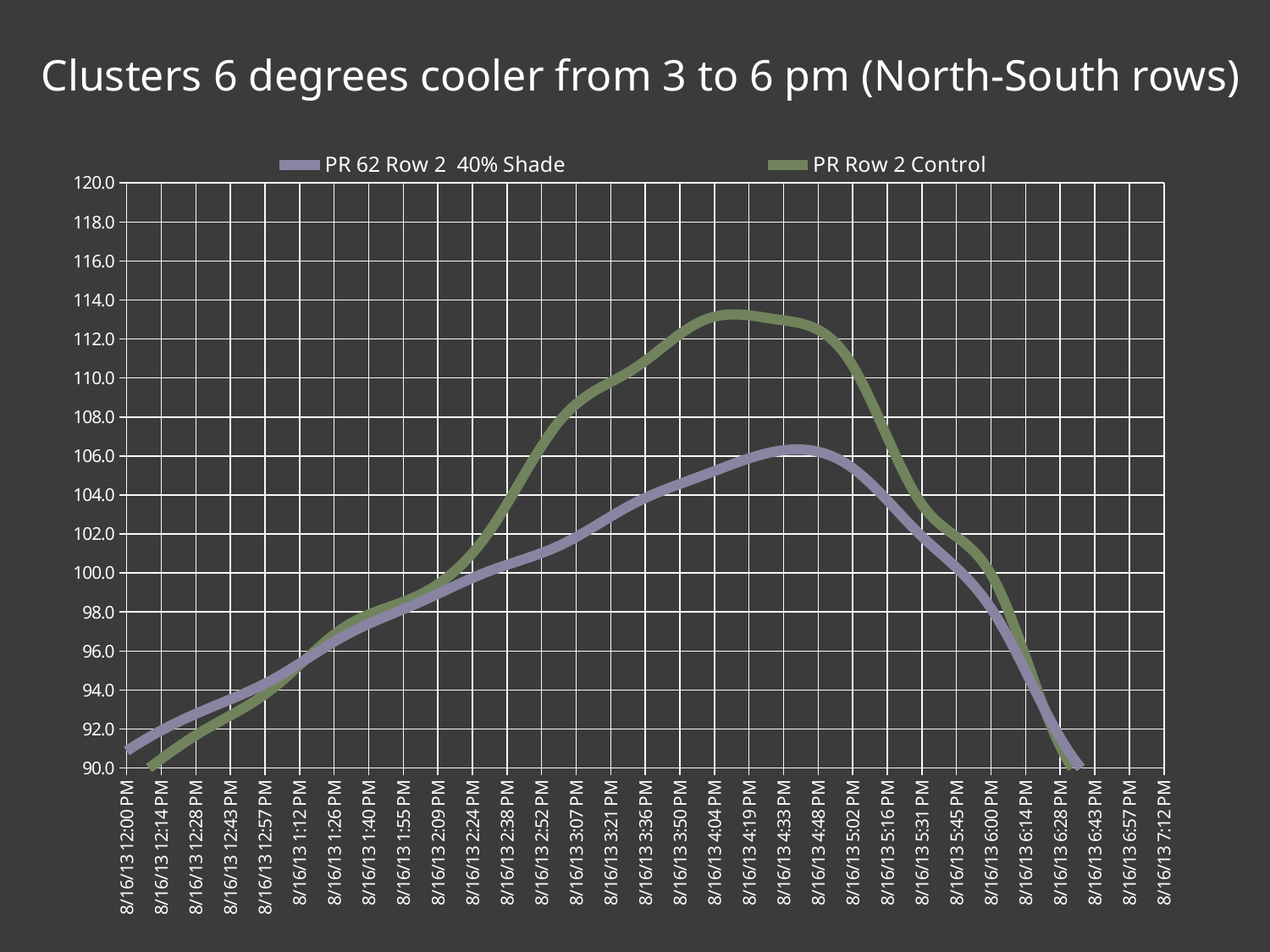
Is the value for PR 62 Row 2 40% Shade at 8/16/13 4:33 PM greater or less than 104.0? greater Is the value for PR 62 Row 2 40% Shade at 8/16/13 2:52 PM greater or less than 100.0? greater What are the two series named in the legend? PR 62 Row 2 40% Shade and PR Row 2 Control Is the value for PR 62 Row 2 40% Shade at 8/16/13 6:28 PM greater or less than 92.0? less Does the PR 62 Row 2 40% Shade series rise or fall between 8/16/13 4:33 PM and 8/16/13 6:28 PM? fall What is the title of the slide? Clusters 6 degrees cooler from 3 to 6 pm (North-South rows) What kind of chart is shown on the slide? line chart How many series does the legend list? 2 At 8/16/13 4:04 PM, which series has the higher value, PR 62 Row 2 40% Shade or PR Row 2 Control? PR Row 2 Control Does the PR Row 2 Control series rise or fall between 8/16/13 12:14 PM and 8/16/13 4:04 PM? rise